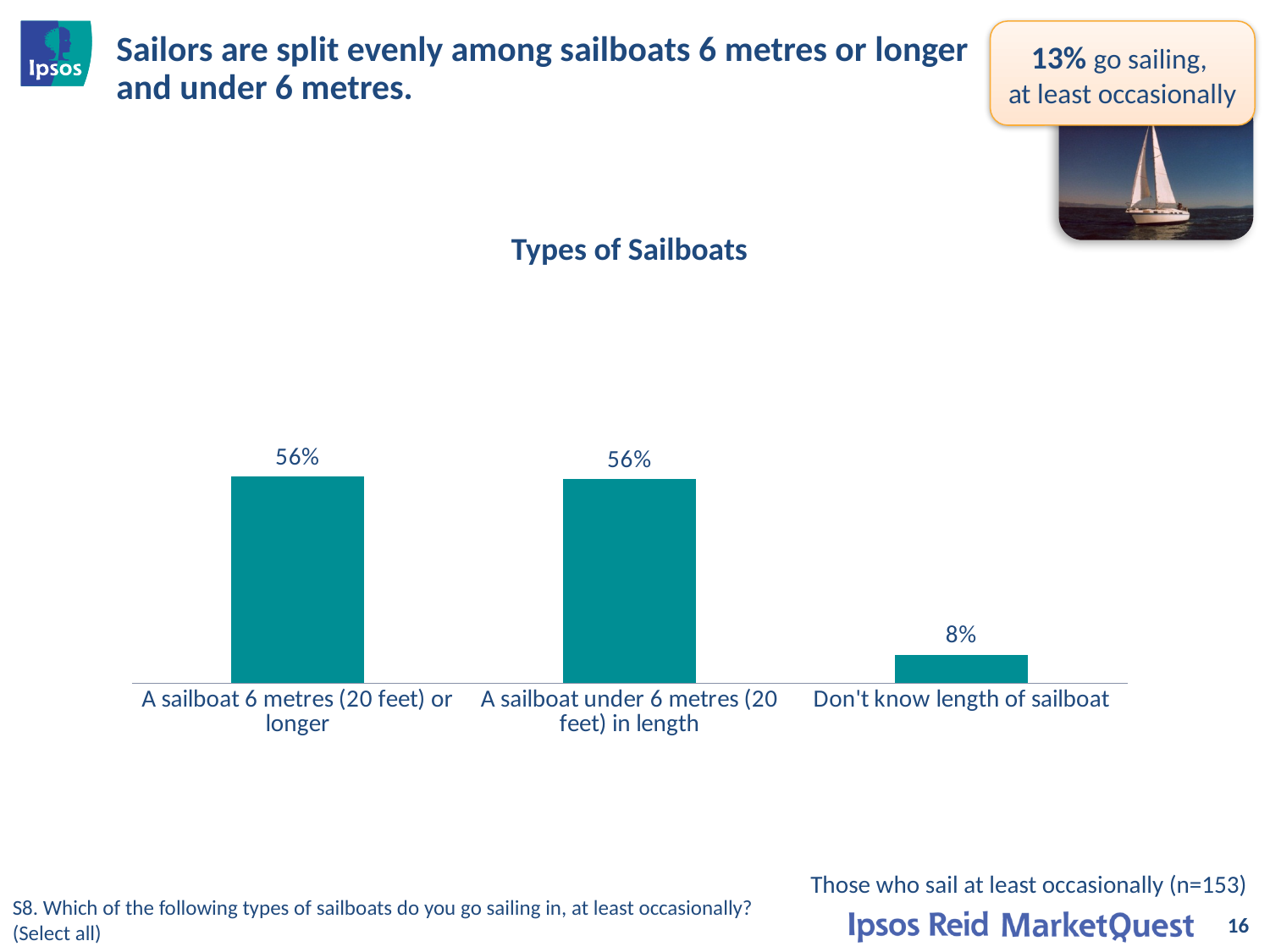
What is the difference between the value for 'A sailboat 6 metres (20 feet) or longer' and the value for 'Don't know length of sailboat'? 48% What is the value for 'A sailboat under 6 metres (20 feet) in length'? 56% What is the difference between the value for 'A sailboat 6 metres (20 feet) or longer' and the value for 'A sailboat under 6 metres (20 feet) in length'? 0% What kind of chart is shown on the slide? Bar chart Which category has the lowest value? Don't know length of sailboat What is the value for 'Don't know length of sailboat'? 8% What is the value for 'A sailboat 6 metres (20 feet) or longer'? 56% How many categories are shown in the chart? 3 What colour are the bars in the chart? Teal Which is larger: the value for 'A sailboat under 6 metres (20 feet) in length' or the value for 'Don't know length of sailboat'? A sailboat under 6 metres (20 feet) in length What is the title of the chart? Types of Sailboats